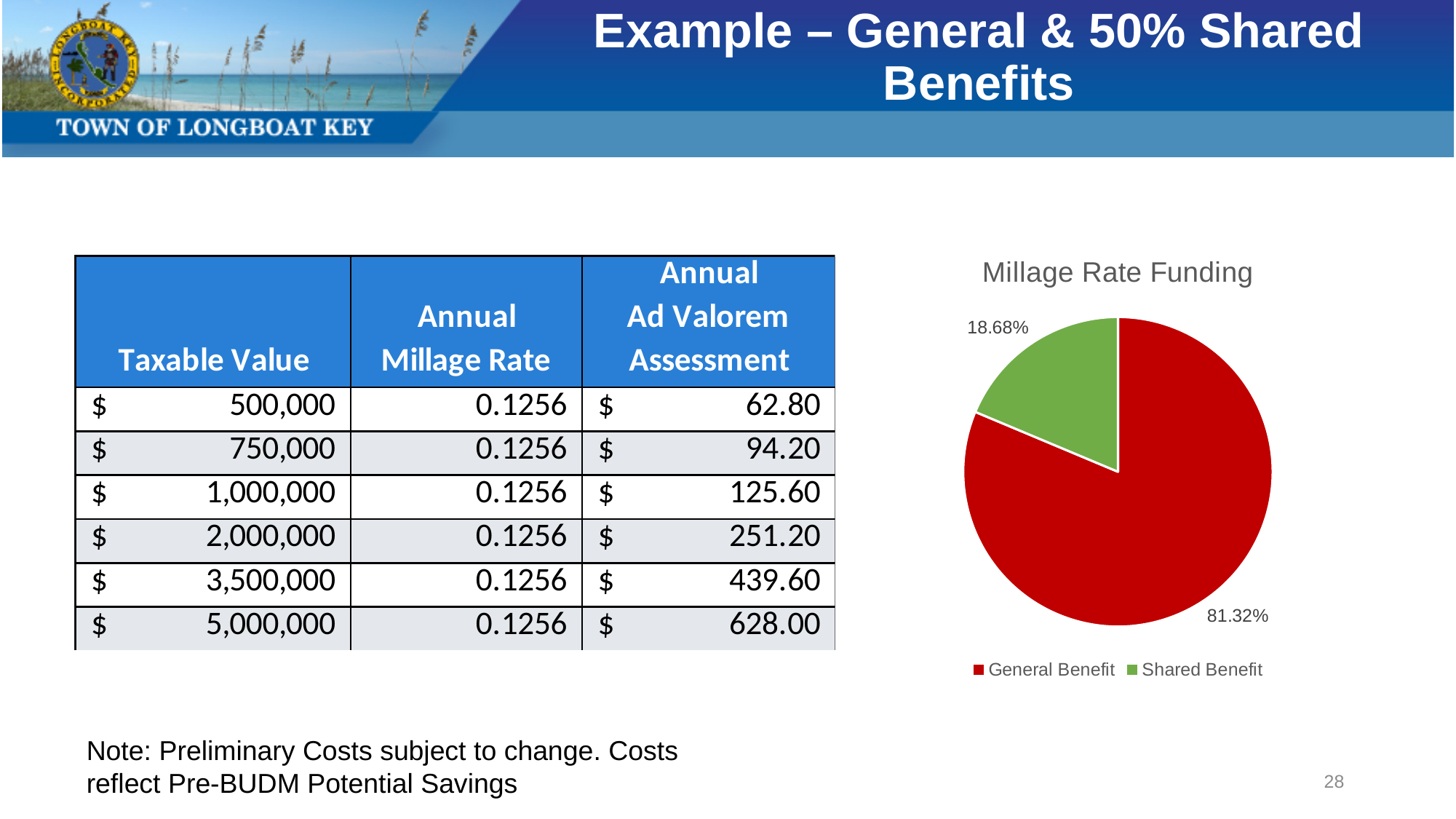
What share of the Millage Rate Funding pie is General Benefit? 81.32% How many slices does the Millage Rate Funding pie chart have? 2 How many entries does the legend of the Millage Rate Funding chart list? 2 In the Millage Rate Funding pie, which is larger: General Benefit or Shared Benefit? General Benefit What is the title of the pie chart? Millage Rate Funding What share of the Millage Rate Funding pie is Shared Benefit? 18.68% What colour is the Shared Benefit slice in the Millage Rate Funding pie? green What is the difference in percentage points between the General Benefit and Shared Benefit slices? 62.64 What type of chart is the Millage Rate Funding chart? pie chart Which slice of the Millage Rate Funding pie is the smallest? Shared Benefit Which slice of the Millage Rate Funding pie is the largest? General Benefit